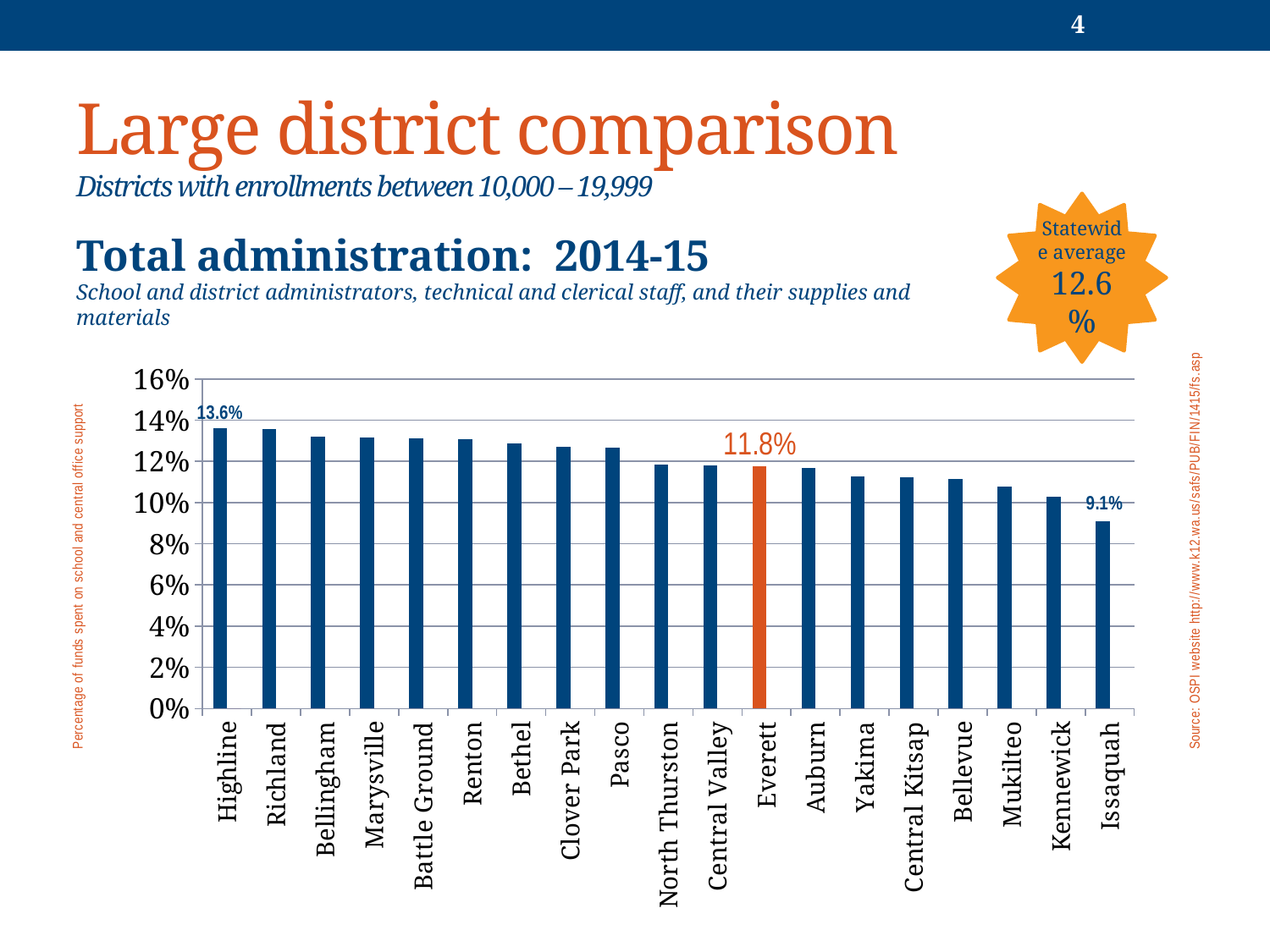
What is the value for Issaquah? 9.1% What is the value for Highline? 13.6% Do the values rise or fall from left to right along the x axis? fall Which is larger, the value for Everett or the value for Issaquah? Everett What is the difference between the values for Highline and Issaquah? 4.5% Is the value for Bellevue greater or less than 12%? less What is the difference between the values for Highline and Everett? 1.8% What is the value for Everett? 11.8% What kind of chart is shown on the slide? bar chart Which district has the lowest value? Issaquah How many districts are shown on the chart? 19 Is the value for Pasco greater or less than 12%? greater